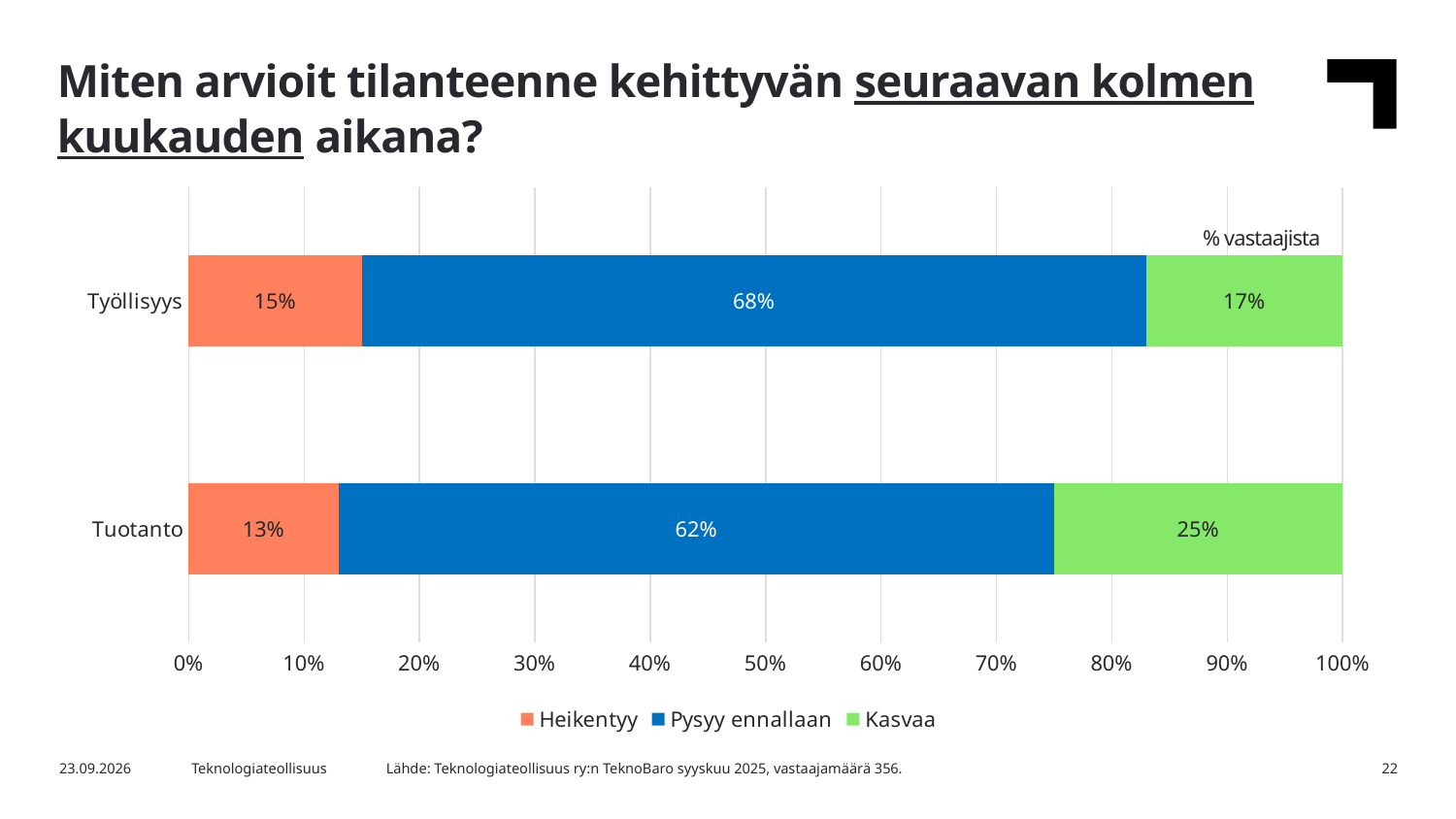
What is the value for Kasvaa in the Työllisyys bar? 17% What is the value for Heikentyy in the Tuotanto bar? 13% Which category has the higher Kasvaa value, Työllisyys or Tuotanto? Tuotanto What is the value for Pysyy ennallaan in the Työllisyys bar? 68% What is the difference between the Pysyy ennallaan values for Työllisyys and Tuotanto? 6 percentage points What is the difference between the Kasvaa values for Tuotanto and Työllisyys? 8 percentage points How many categories are shown on the chart? 2 What kind of chart is shown on the slide? Stacked bar chart What is the value for Kasvaa in the Tuotanto bar? 25% Which series has the largest share in the Tuotanto bar? Pysyy ennallaan Which series has the smallest share in the Työllisyys bar? Heikentyy How many series does the legend list? 3